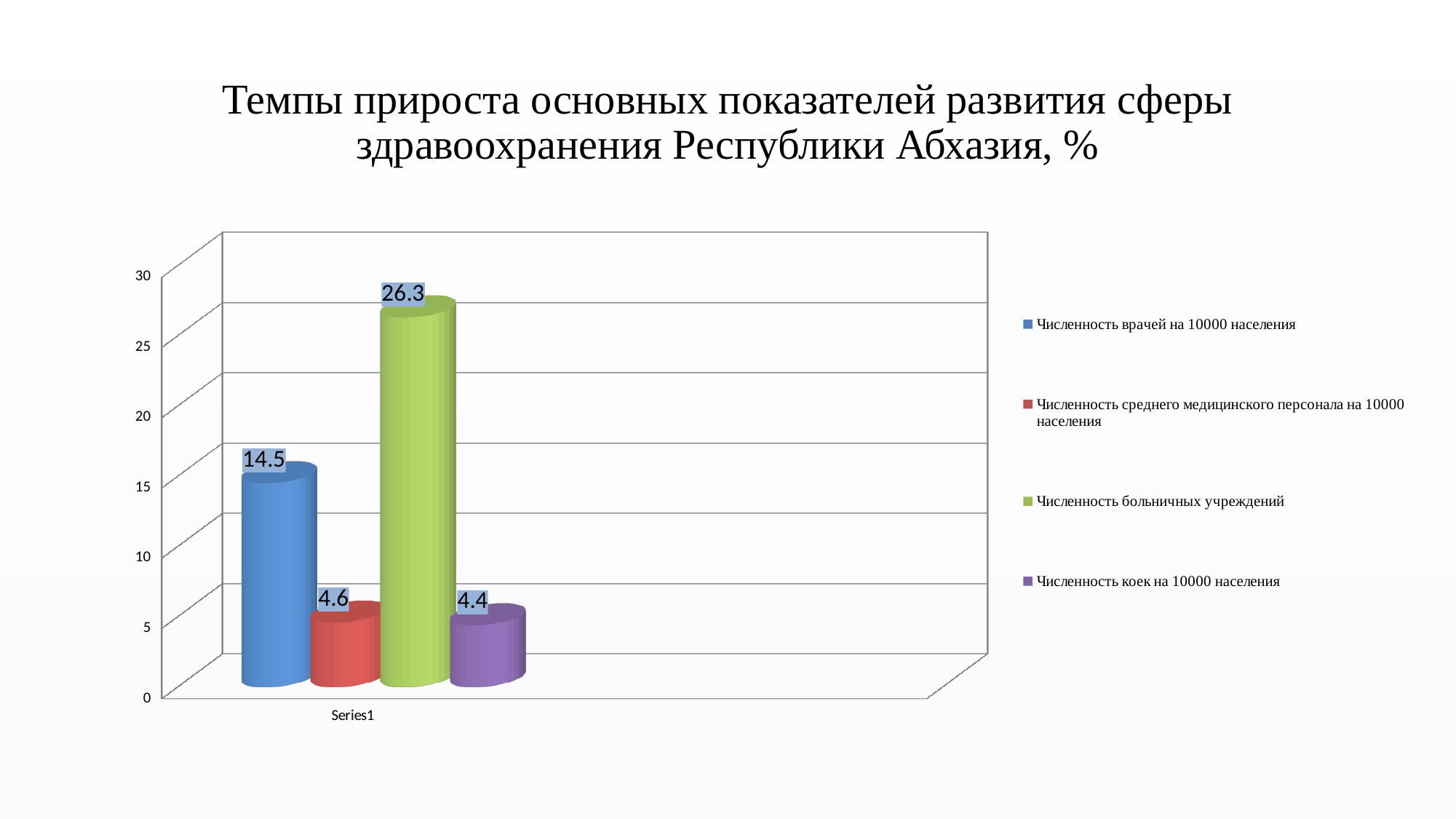
Is the value for Численность больничных учреждений greater or less than 25? greater What kind of chart is shown on the slide? bar chart What is the value for Численность коек на 10000 населения? 4.4 How many series does the legend list? 4 What is the value for Численность больничных учреждений? 26.3 What is the value for Численность врачей на 10000 населения? 14.5 What colour is the bar for Численность больничных учреждений? green What is the difference between the values for Численность среднего медицинского персонала на 10000 населения and Численность коек на 10000 населения? 0.2 What is the difference between the values for Численность больничных учреждений and Численность врачей на 10000 населения? 11.8 Which series has the highest value? Численность больничных учреждений What is the value for Численность среднего медицинского персонала на 10000 населения? 4.6 Which is larger: the value for Численность врачей на 10000 населения or the value for Численность коек на 10000 населения? Численность врачей на 10000 населения